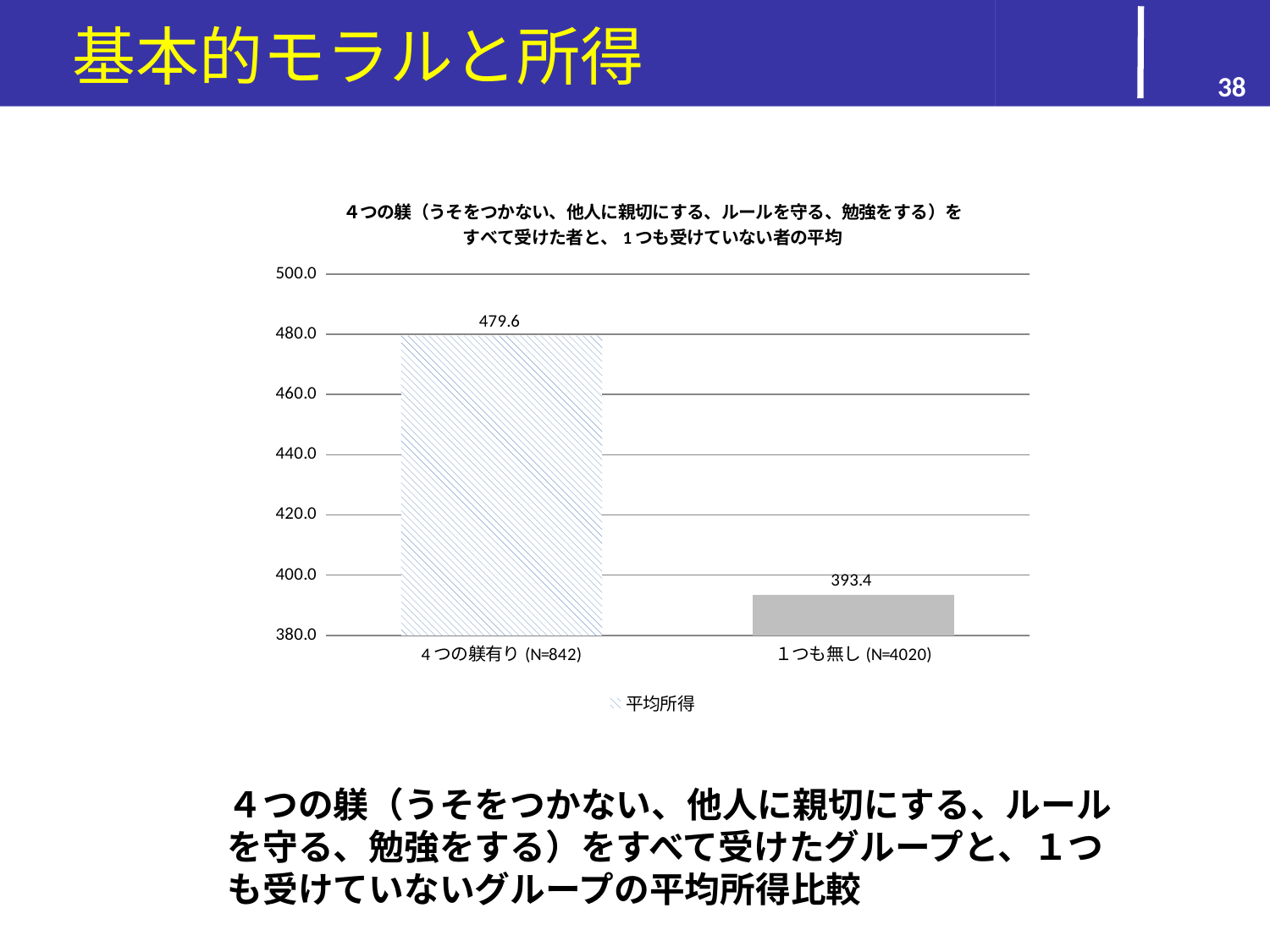
Which category has the highest value? ４つの躾有り (N=842) How many categories are shown on the x axis? 2 What is the difference between the values for ４つの躾有り (N=842) and １つも無し (N=4020)? 86.2 What kind of chart is shown on the slide? bar chart What is the value for １つも無し (N=4020)? 393.4 Which category has the lowest value? １つも無し (N=4020) What is the value for ４つの躾有り (N=842)? 479.6 Is the value for ４つの躾有り (N=842) greater or less than 460.0? greater What is the legend entry for the series shown? 平均所得 Is the value for １つも無し (N=4020) greater or less than 400.0? less How many series does the legend list? 1 Which is larger, the value for ４つの躾有り (N=842) or the value for １つも無し (N=4020)? ４つの躾有り (N=842)